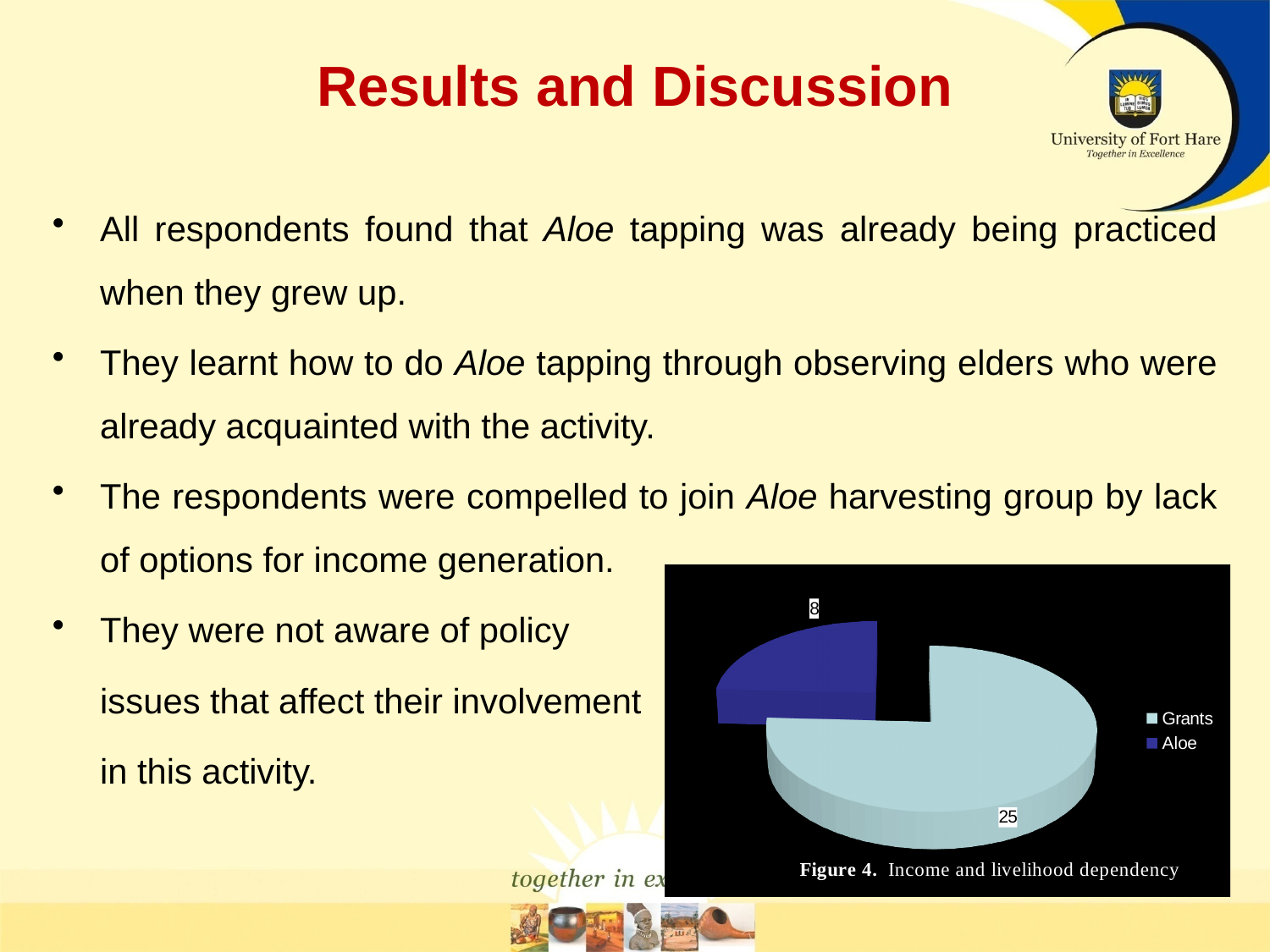
What kind of chart is shown on the slide? Pie chart What is the difference between the Grants value and the Aloe value in the pie chart? 17 Which is larger in the pie chart, Grants or Aloe? Grants What is the caption of the chart on the slide? Figure 4. Income and livelihood dependency How many slices does the pie chart have? 2 What value is shown for the Grants slice in the pie chart? 25 What colour is the Aloe slice in the pie chart? Dark blue What value is shown for the Aloe slice in the pie chart? 8 How many entries does the legend of the pie chart list? 2 Which category has the largest slice in the pie chart? Grants What is the total of the two values shown in the pie chart? 33 Which category has the smallest slice in the pie chart? Aloe